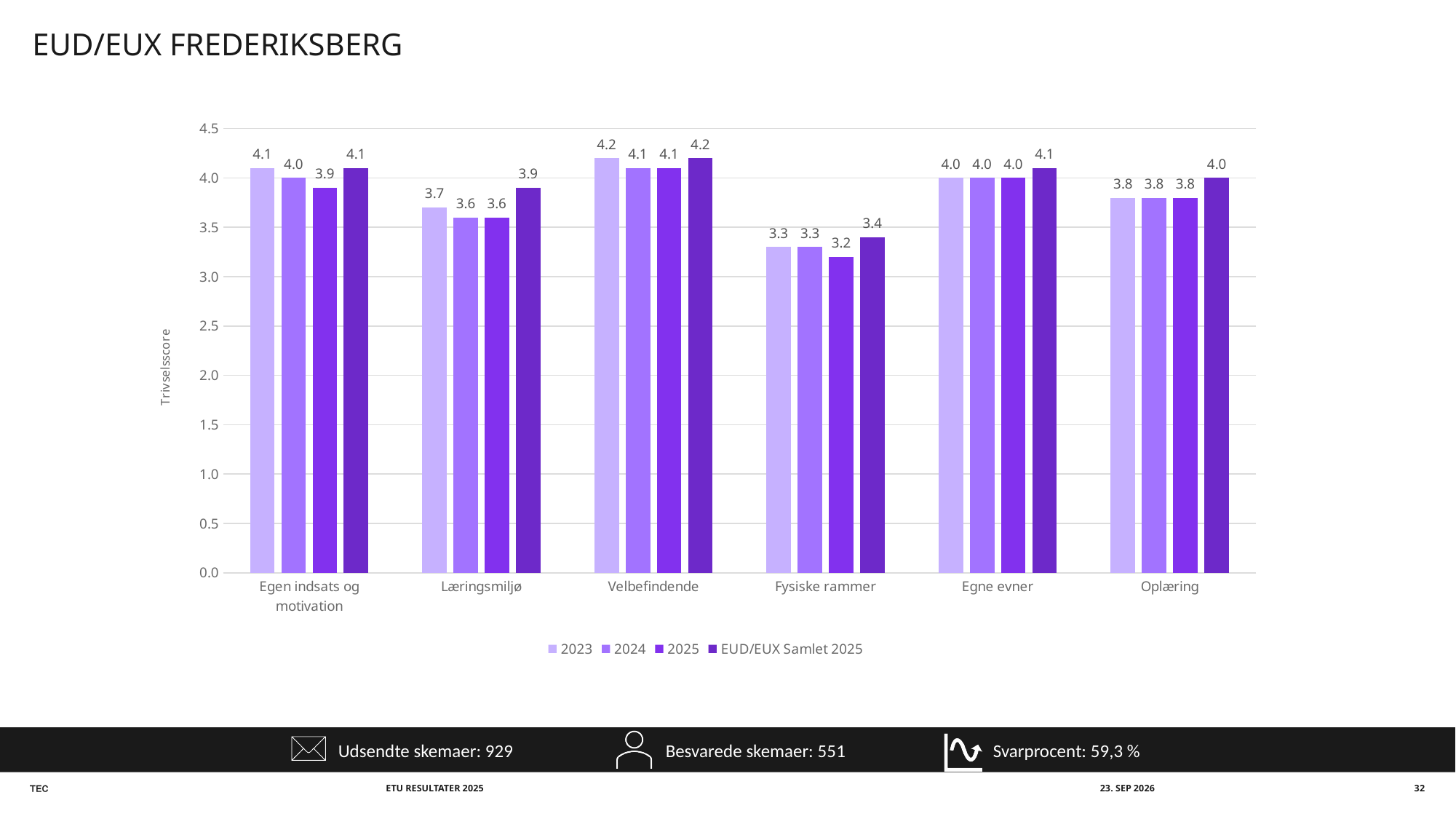
What is the difference between the EUD/EUX Samlet 2025 value and the 2025 value for Læringsmiljø? 0.3 Which category has the highest 2025 value? Velbefindende What is the 2025 value for Læringsmiljø? 3.6 What is the 2023 value for Velbefindende? 4.2 How many series does the legend list? 4 What is the EUD/EUX Samlet 2025 value for Fysiske rammer? 3.4 What kind of chart is shown on the slide? bar chart Is the 2024 value for Fysiske rammer greater or less than 3.5? less Which category has the lowest 2025 value? Fysiske rammer What is the label on the vertical axis? Trivselsscore How many categories are shown on the x axis? 6 Which is larger for Egen indsats og motivation: the 2023 value or the 2025 value? 2023